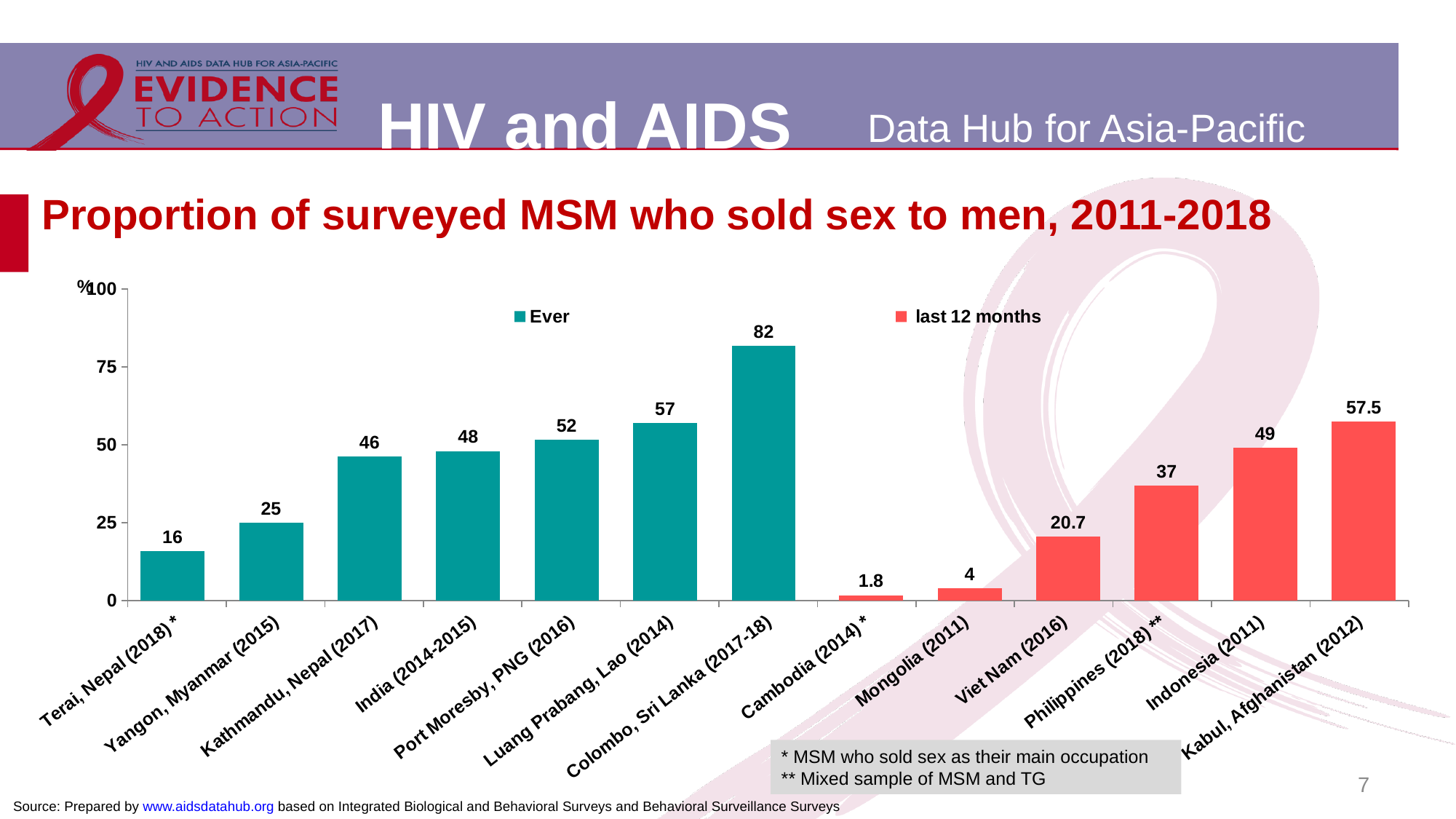
What is the value for Viet Nam (2016)? 20.7 Which is larger, the value for Philippines (2018)** or the value for Indonesia (2011)? Indonesia (2011) What is the value for Kabul, Afghanistan (2012)? 57.5 What kind of chart is shown on the slide? bar chart How many series does the legend list? 2 Is the value for Kathmandu, Nepal (2017) greater or less than 50? less Which category has the lowest value in the chart? Cambodia (2014)* What is the value for Colombo, Sri Lanka (2017-18)? 82 What is the difference between the values for Luang Prabang, Lao (2014) and Yangon, Myanmar (2015)? 32 How many categories are shown on the x axis? 13 Which category has the highest value in the chart? Colombo, Sri Lanka (2017-18) Which series is shown in red? last 12 months